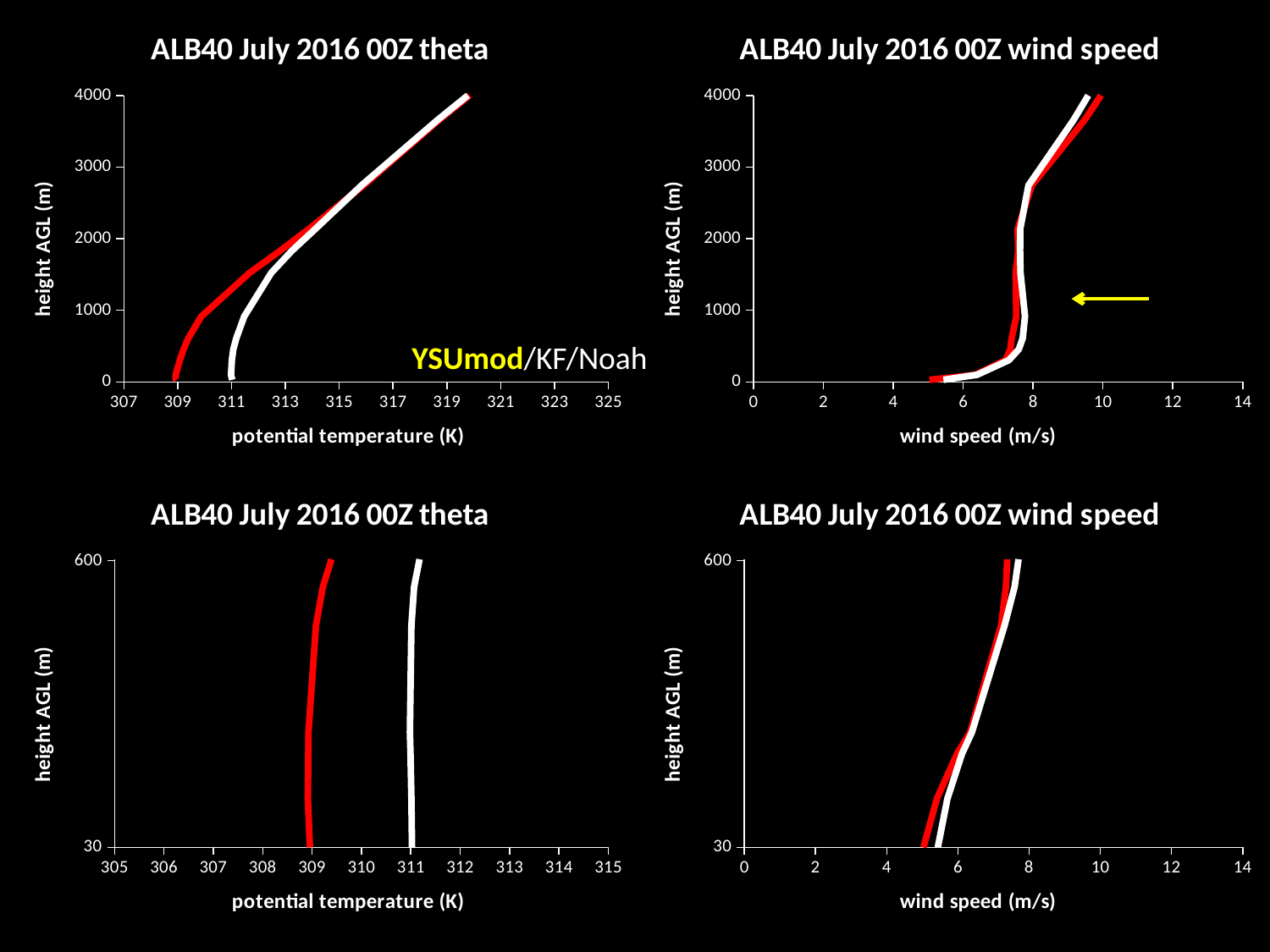
How many charts are shown on the slide? 4 In the bottom-left chart "ALB40 July 2016 00Z theta", is the red line's potential temperature at 30 m greater or less than 310? less In the bottom-right chart "ALB40 July 2016 00Z wind speed", does wind speed rise or fall as height increases from 30 m to 600 m? rise In the top-right chart "ALB40 July 2016 00Z wind speed", is the red line's wind speed at 4000 m greater or less than 8? greater In the bottom-left chart "ALB40 July 2016 00Z theta", which line shows the higher potential temperature, the red line or the white line? the white line In the top-right chart "ALB40 July 2016 00Z wind speed", what is the highest tick value on the x axis? 14 In the top-left chart "ALB40 July 2016 00Z theta", what is the x-axis label? potential temperature (K) In the top-left chart "ALB40 July 2016 00Z theta", is the potential temperature at 4000 m greater or less than 317? greater What kind of chart is the top-left chart titled "ALB40 July 2016 00Z theta"? line chart